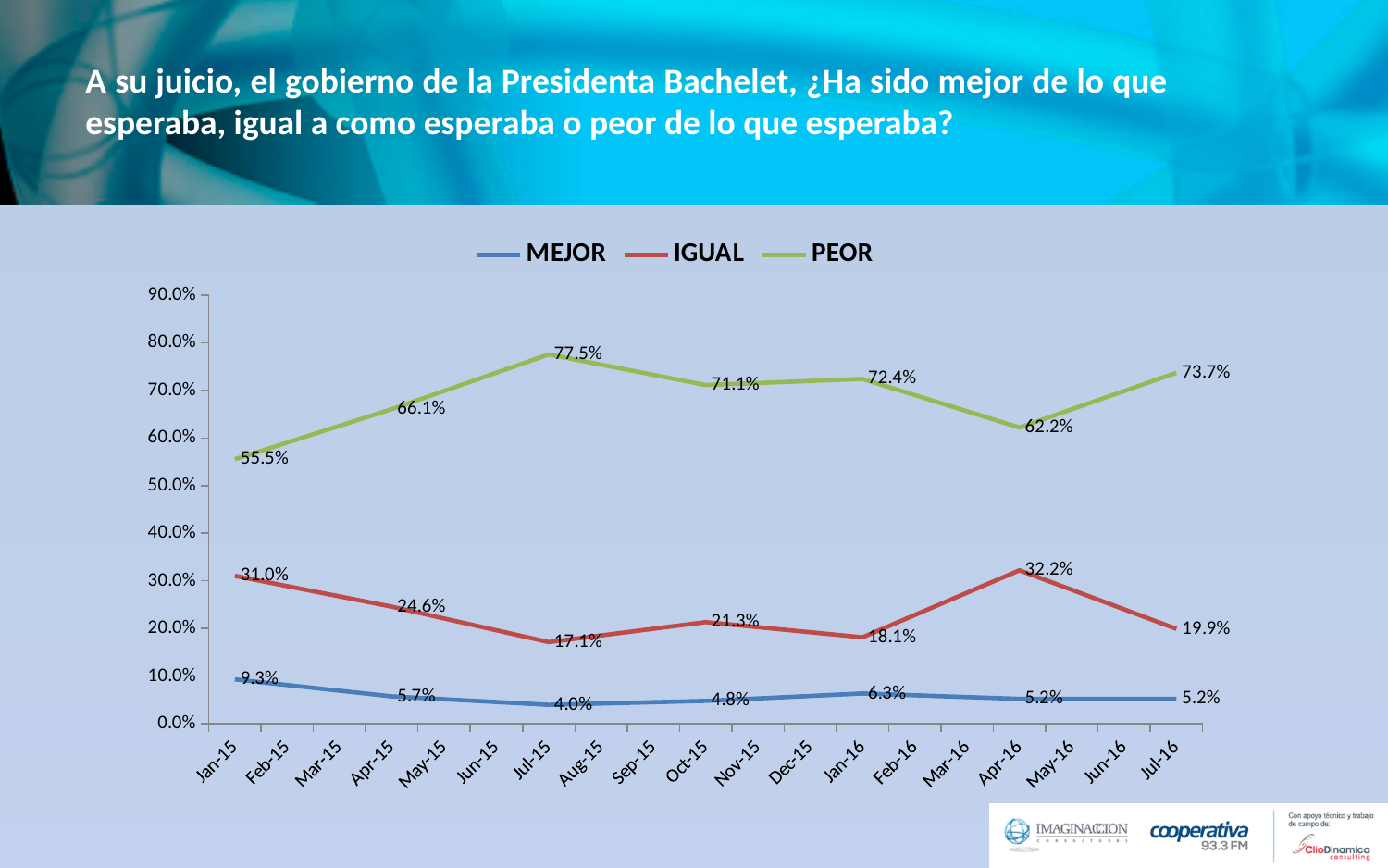
Which is larger: the IGUAL value at Jan-15 or the IGUAL value at Jul-16? Jan-15 At which date does the PEOR series reach its highest value? Jul-15 What type of chart is shown on the slide? line chart How many series does the legend list? 3 What is the value of the PEOR series at Jul-15? 77.5% At which date does the MEJOR series reach its lowest value? Jul-15 Which series is drawn in green in the legend? PEOR What is the value of the MEJOR series at Jan-15? 9.3% Does the PEOR series rise or fall from Jan-15 to Jul-15? rise What is the difference between the PEOR value at Jul-16 and the PEOR value at Apr-16? 11.5% How many data points are labelled on the PEOR line? 7 What is the value of the IGUAL series at Apr-16? 32.2%